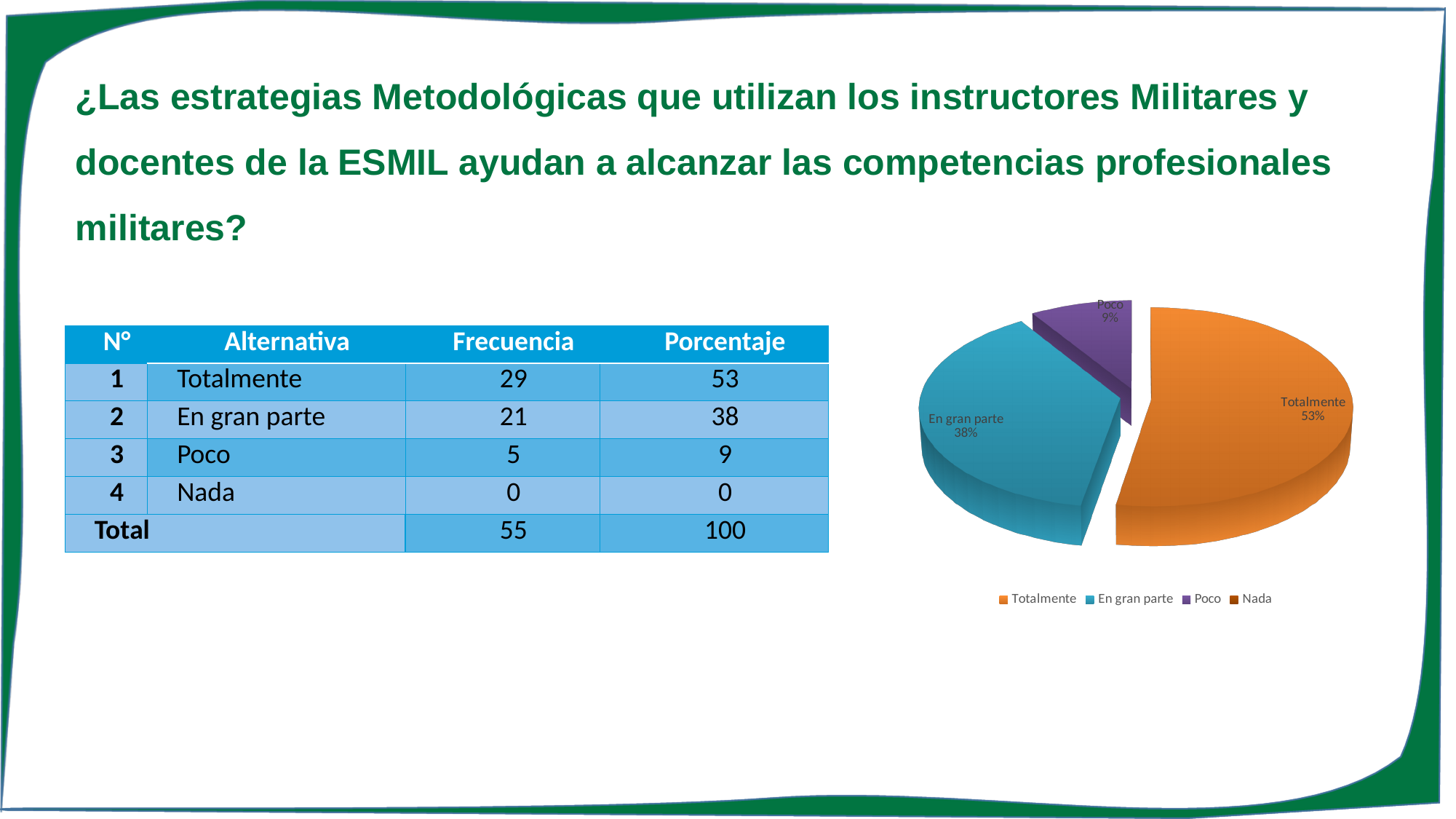
What colour is the Totalmente slice in the pie chart? orange Which slice is larger in the pie chart, En gran parte or Poco? En gran parte What is the difference in percentage points between the Totalmente and En gran parte slices? 15 How many entries does the pie chart legend list? 4 What kind of chart is shown on the slide? pie chart What is the combined percentage of the Totalmente and En gran parte slices? 91% What percentage does the pie chart show for Poco? 9% Which labelled slice in the pie chart is the smallest? Poco Which legend entry of the pie chart has no visible slice? Nada Which category has the largest slice in the pie chart? Totalmente What percentage does the pie chart show for Totalmente? 53% What percentage does the pie chart show for En gran parte? 38%